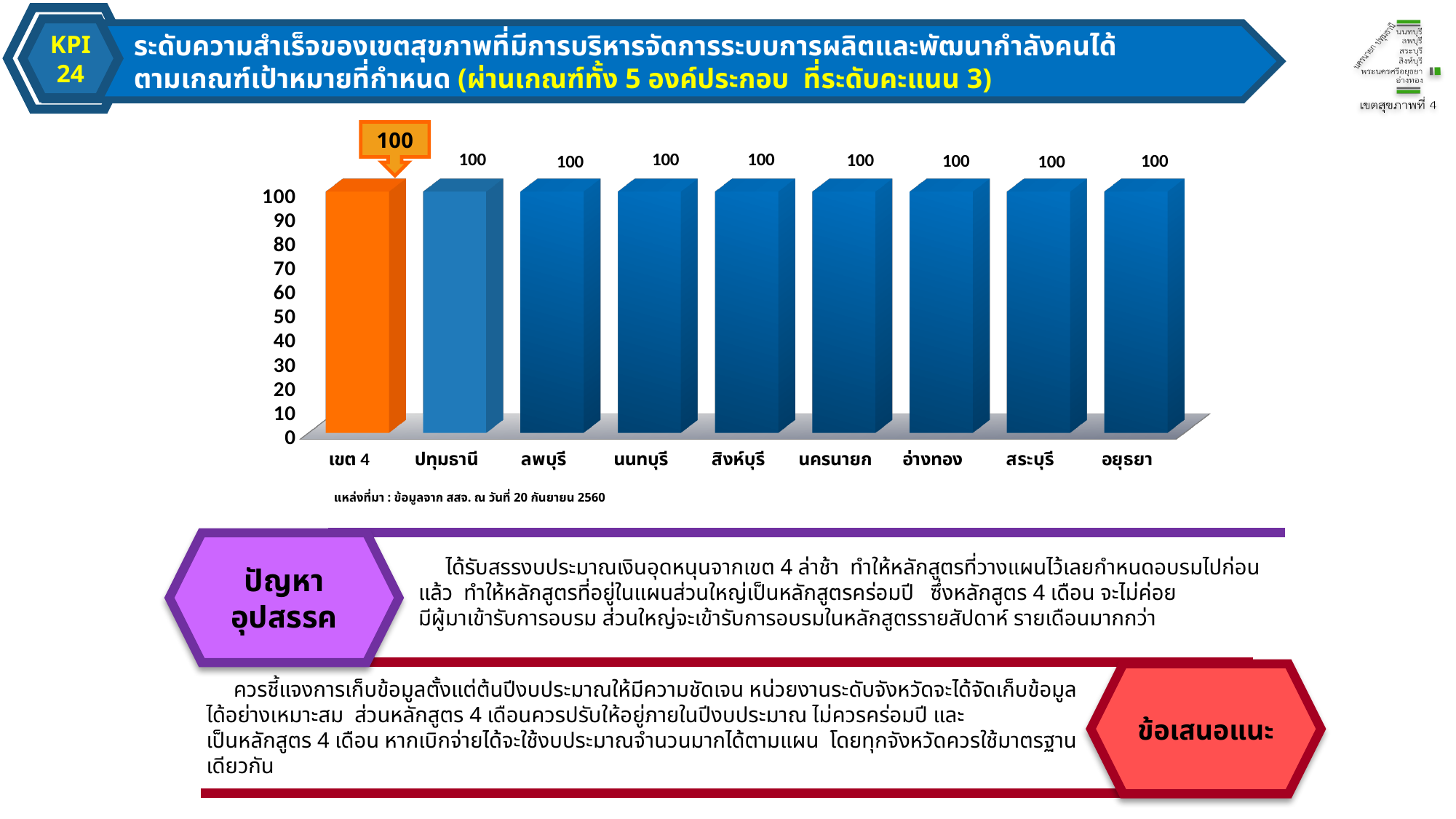
What is the value for เขต 4? 100 Is the value for สิงห์บุรี greater or less than 50? greater What is the value for อยุธยา? 100 What kind of chart is shown on the slide? bar chart What colour is the bar for เขต 4? orange What is the difference between the values for เขต 4 and ลพบุรี? 0 What is the value for อ่างทอง? 100 What is the value for ปทุมธานี? 100 Do the values rise, fall, or stay the same across the categories from left to right? stay the same How many categories are shown on the x axis of the chart? 9 What is the value for นครนายก? 100 What is the highest value shown on the y axis of the chart? 100